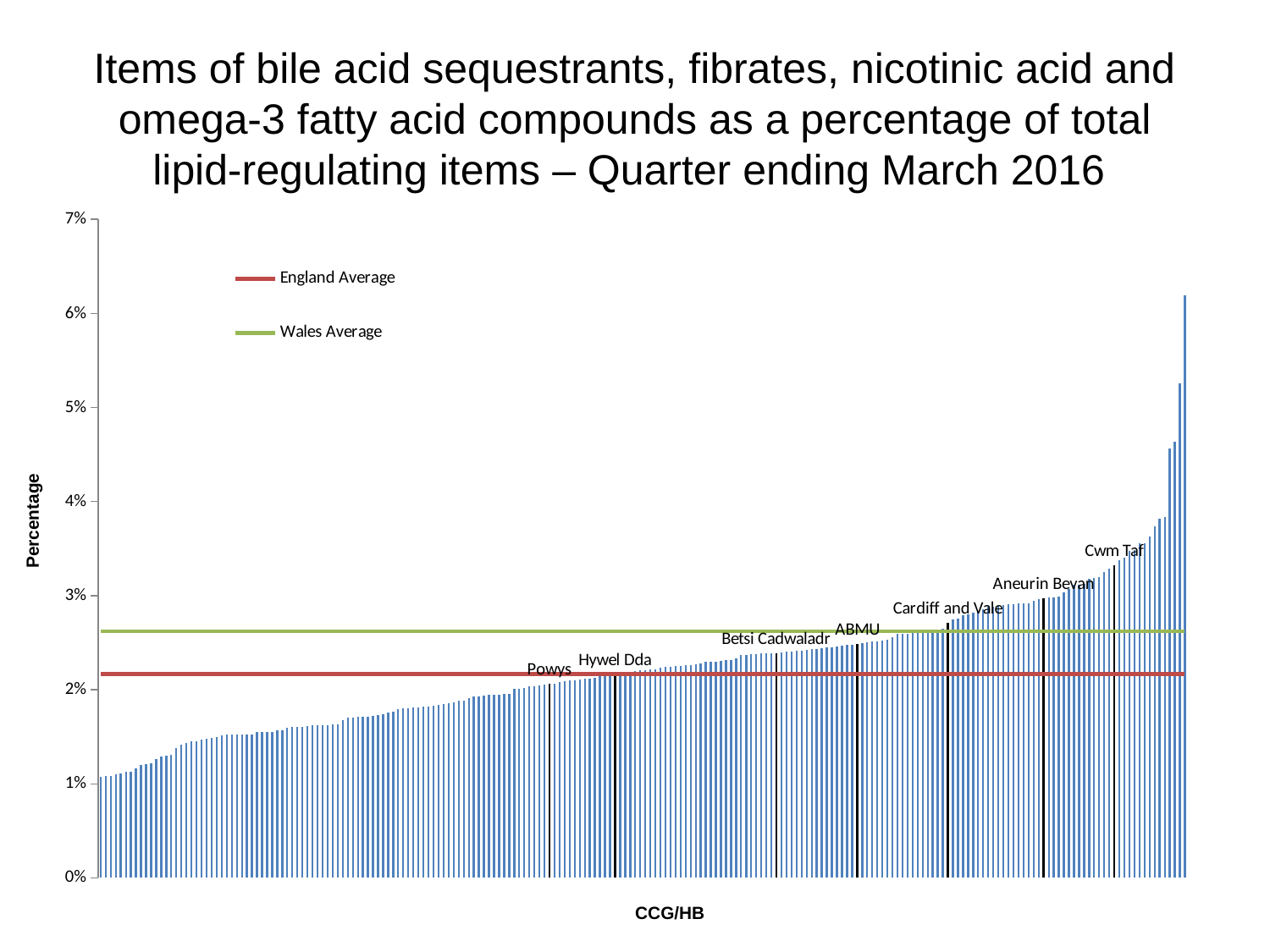
Which of the labelled Welsh health boards has the lowest percentage? Powys How many entries does the legend list? 2 Is the value for Betsi Cadwaladr greater or less than 3%? less Is the value for Cardiff and Vale greater or less than 2%? greater What kind of chart is shown on the slide? bar chart Which of the labelled Welsh health boards has the highest percentage? Cwm Taf Which has the larger value, Cwm Taf or Hywel Dda? Cwm Taf Which is higher, the Wales Average line or the England Average line? Wales Average What is the label on the x axis of the chart? CCG/HB Is the value for Powys greater or less than 3%? less Do the bar values rise or fall from left to right along the x axis? rise